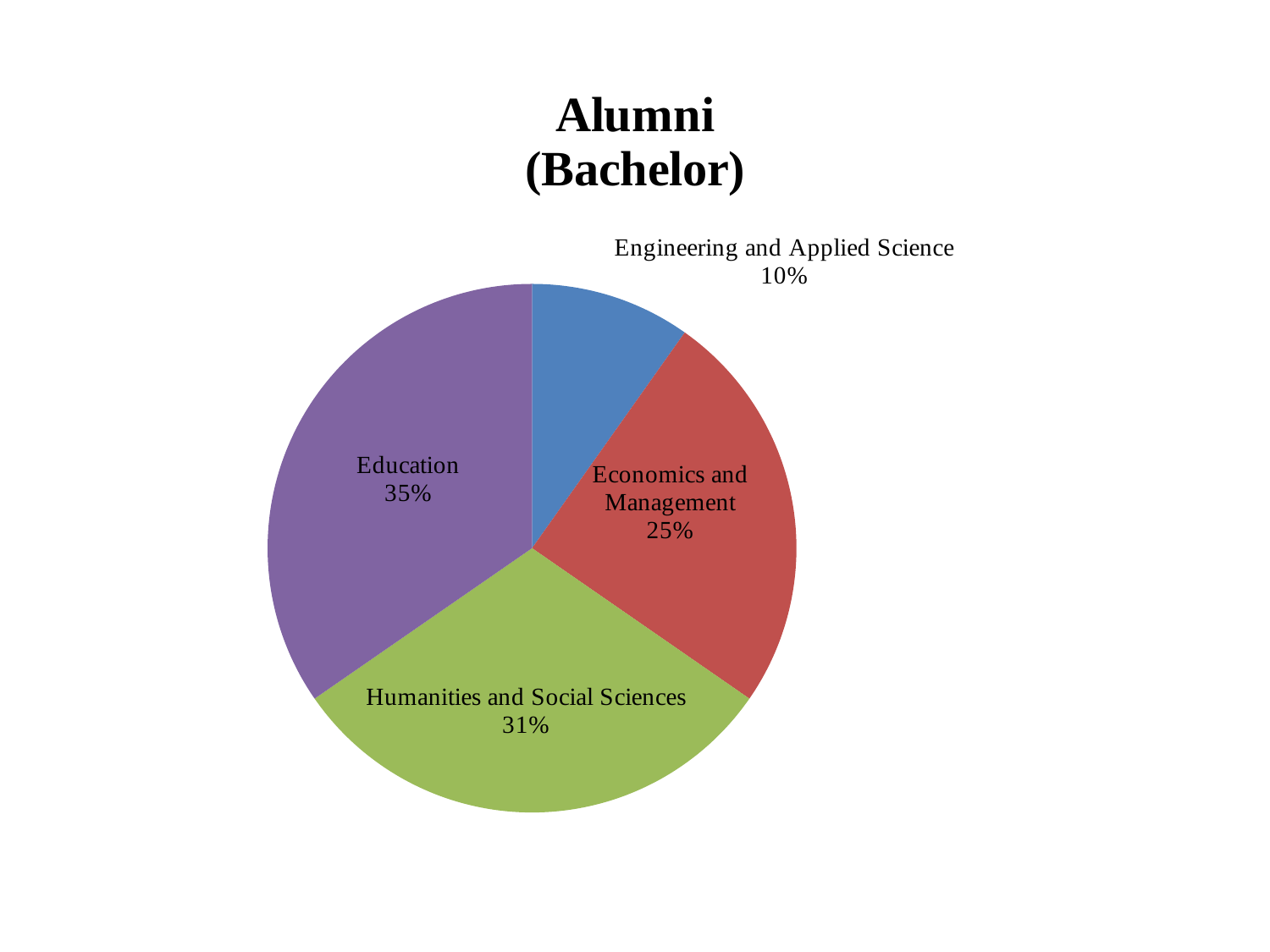
What share of the pie does Education represent? 35% Which category has the largest share of the pie? Education What type of chart is shown on the slide? pie chart What is the title of the chart? Alumni (Bachelor) Which category has the smallest share of the pie? Engineering and Applied Science How many categories are shown in the pie chart? 4 What colour is the Education slice? purple Which is larger, the share for Humanities and Social Sciences or the share for Economics and Management? Humanities and Social Sciences What is the difference between the shares of Education and Economics and Management? 10% What is the value shown for Humanities and Social Sciences? 31% What share of the pie does Engineering and Applied Science represent? 10% What is the value shown for Economics and Management? 25%